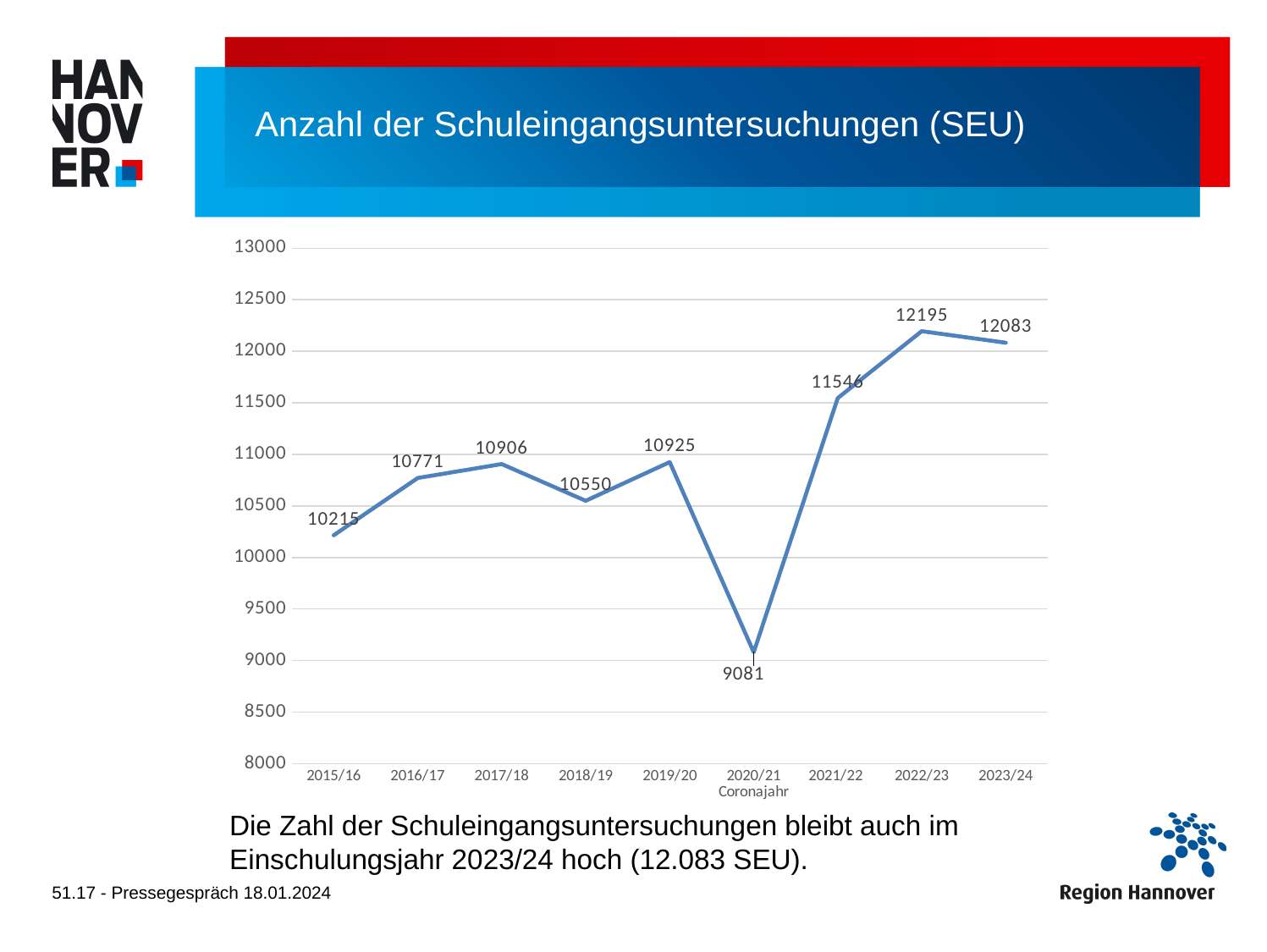
Which year has the highest value? 2022/23 What is the title of the chart? Anzahl der Schuleingangsuntersuchungen (SEU) What is the value for 2015/16? 10215 What is the difference between the values for 2021/22 and 2020/21? 2465 How many years are plotted on the chart? 9 What kind of chart is shown on the slide? line chart What is the value for 2020/21 Coronajahr? 9081 Which year has the lowest value? 2020/21 Coronajahr Is the value for 2019/20 greater or less than 11000? less What is the value for 2023/24? 12083 What is the difference between the values for 2022/23 and 2023/24? 112 Which is larger, the value for 2017/18 or the value for 2018/19? 2017/18